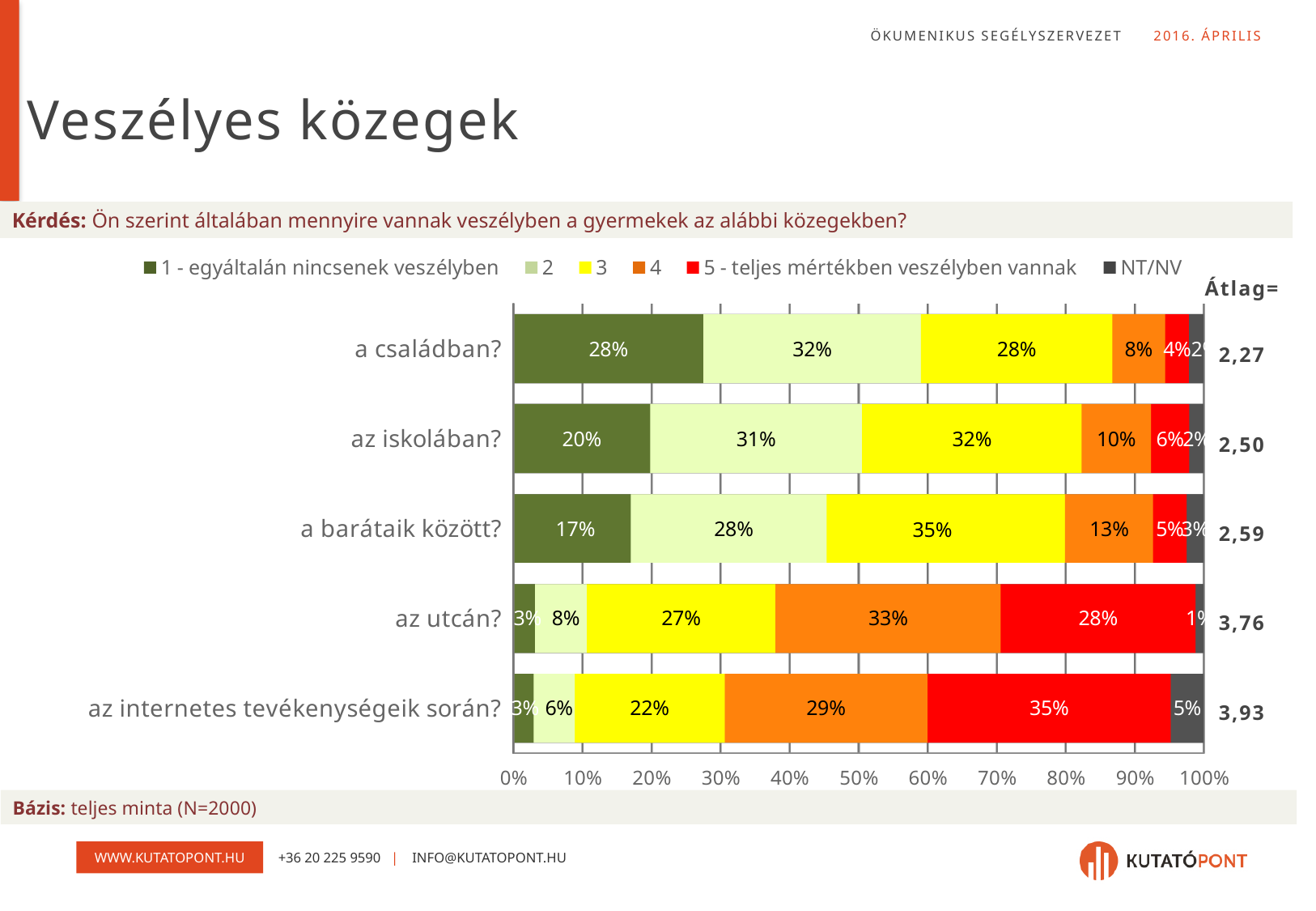
Which is larger: the series '4' value for 'az iskolában?' or for 'a barátaik között?'? a barátaik között? What kind of chart is shown on the slide? stacked bar chart What is the difference between the series '2' values for 'a családban?' and 'az internetes tevékenységeik során?'? 26% What is the value of series '5 - teljes mértékben veszélyben vannak' for 'az internetes tevékenységeik során?'? 35% What is the value of series '3' for 'a barátaik között?'? 35% What is the Átlag (average) value shown for 'az utcán?'? 3,76 Which category has the lowest value for series '5 - teljes mértékben veszélyben vannak'? a családban? What is the value of series '1 - egyáltalán nincsenek veszélyben' for 'az iskolában?'? 20% Which category has the highest value for series '1 - egyáltalán nincsenek veszélyben'? a családban? How many categories (közegek) are plotted on the chart? 5 How many series does the legend list? 6 What is the value of series '4' for 'az utcán?'? 33%